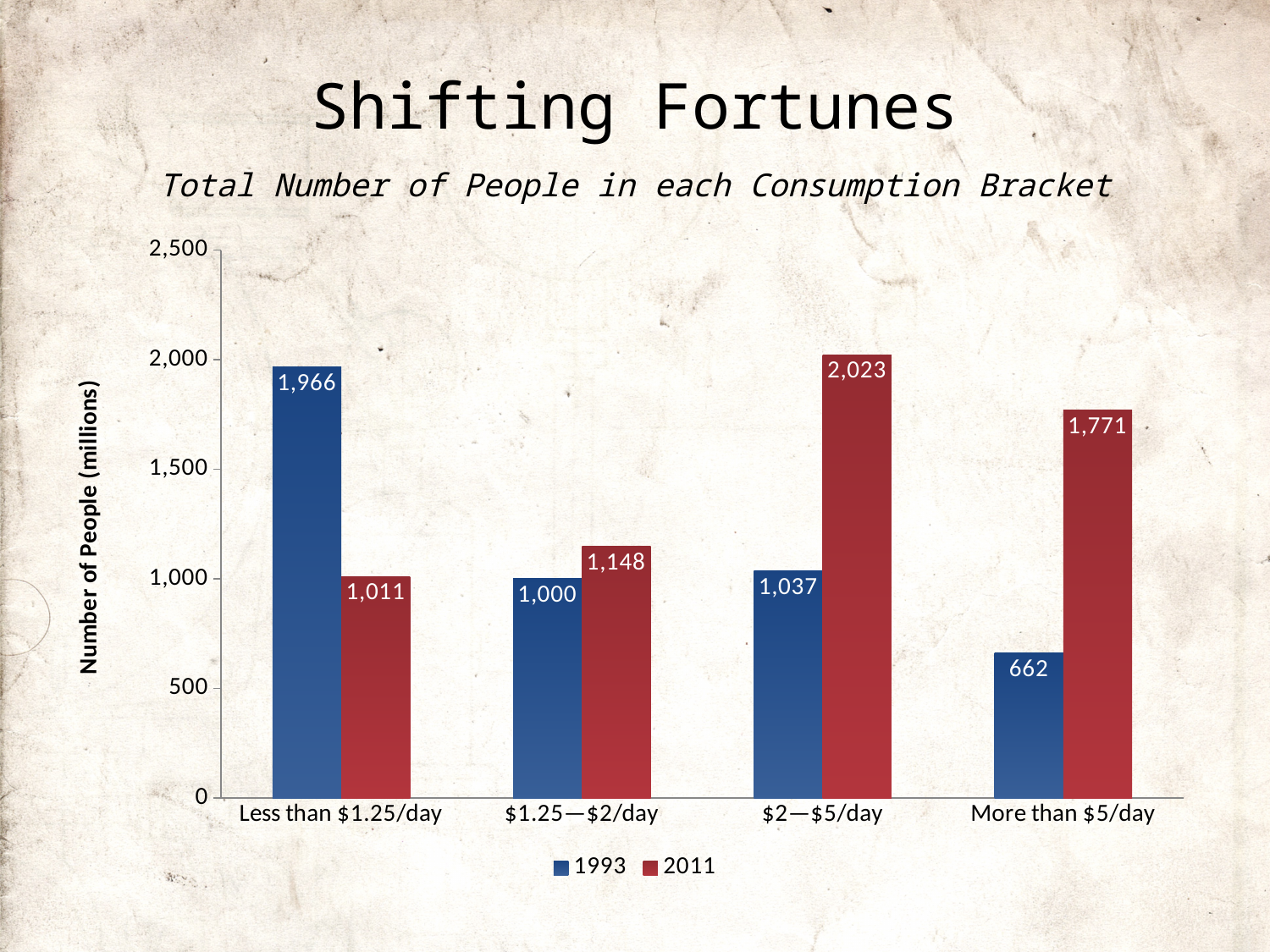
How many consumption brackets are shown on the x axis? 4 What is the difference between the 2011 and 1993 values in the 'More than $5/day' bracket? 1,109 How many series does the legend list? 2 What is the value for 2011 in the '$2—$5/day' bracket? 2,023 What is the value for 1993 in the 'Less than $1.25/day' bracket? 1,966 What is the label of the vertical axis? Number of People (millions) What is the value for 2011 in the 'More than $5/day' bracket? 1,771 Which consumption bracket has the highest value for 1993? Less than $1.25/day What kind of chart is shown on the slide? bar chart Is the 1993 value for 'More than $5/day' greater or less than 1,000? less Which is larger in the '$1.25—$2/day' bracket, the 1993 value or the 2011 value? 2011 Which consumption bracket has the lowest value for 2011? Less than $1.25/day